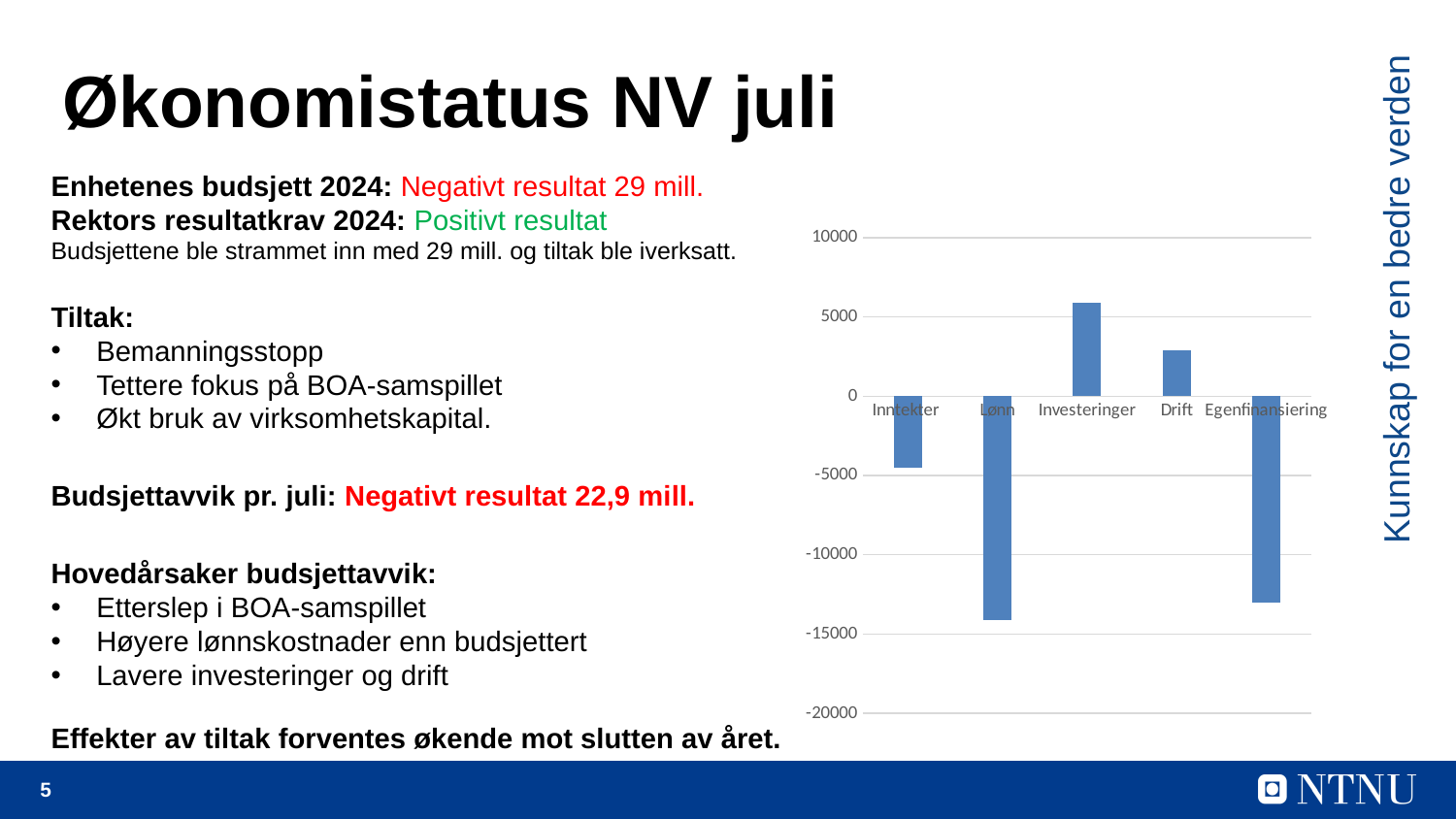
Is the value for Inntekter greater or less than 0? less Which category has the highest value in the chart? Investeringer What kind of chart is shown on the slide? bar chart Which category has the lowest value in the chart? Lønn What is the lowest value shown on the vertical axis of the chart? -20000 Is the value for Egenfinansiering greater or less than -10000? less Which is larger, the value for Investeringer or the value for Drift? Investeringer Is the value for Drift greater or less than 5000? less How many categories in the chart have a positive value? 2 How many categories are shown on the x axis of the chart? 5